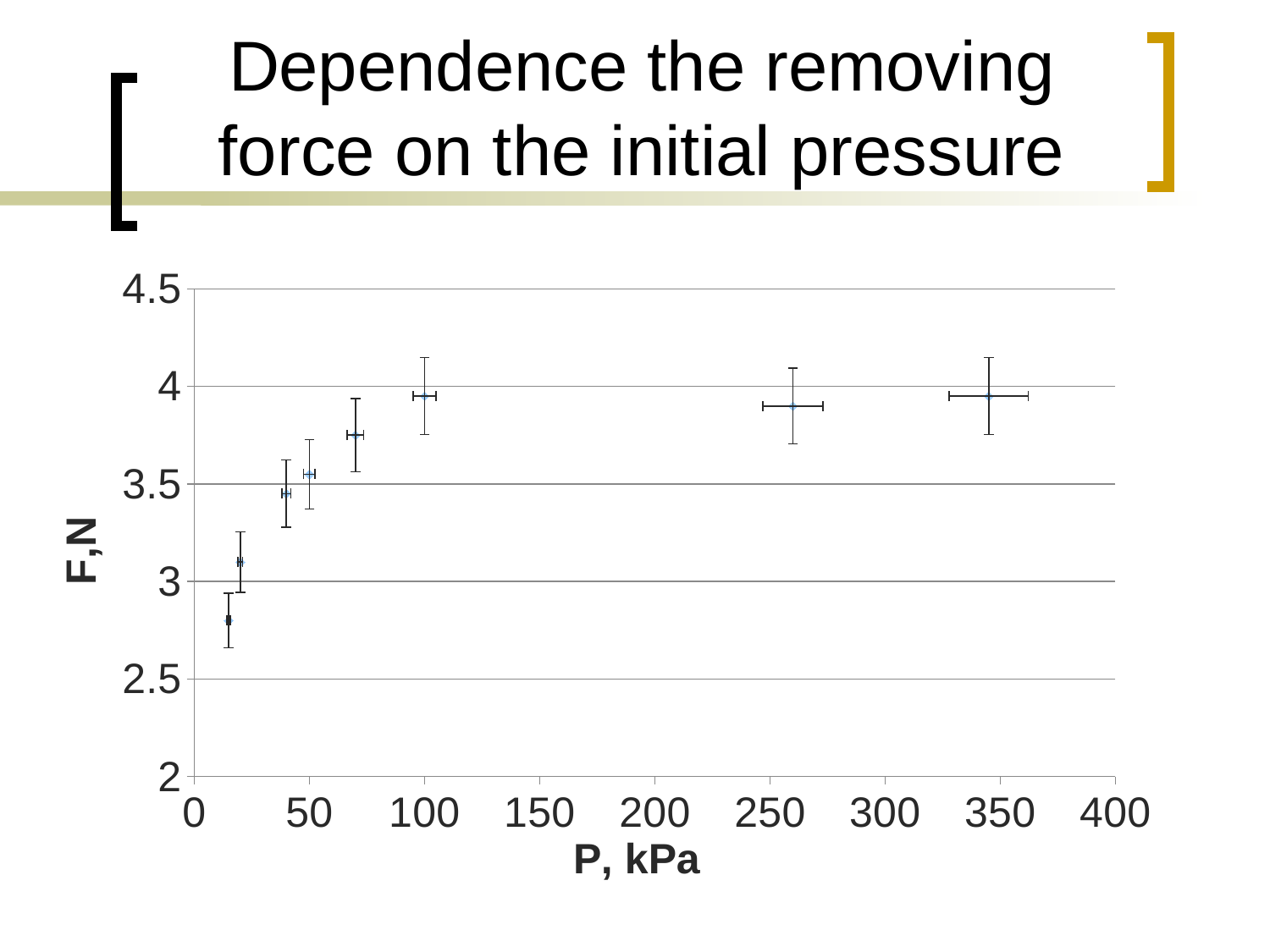
What kind of chart is shown on the slide? Scatter chart Which data point has the lowest F value? The point at about 15 kPa Do the F values generally rise or fall as P increases from 0 to 100 kPa? Rise Which has the larger F value: the point at about 100 kPa or the point at about 15 kPa? The point at about 100 kPa Is the F value for the point at about 100 kPa greater or less than 3.5? greater Which has the larger F value: the point at about 70 kPa or the point at about 40 kPa? The point at about 70 kPa Is the F value for the point at about 15 kPa greater or less than 3? less How many data points are plotted on the chart? 8 What is the label of the x axis? P, kPa Is the F value for the point at about 260 kPa greater or less than 3.5? greater What is the label of the y axis? F,N